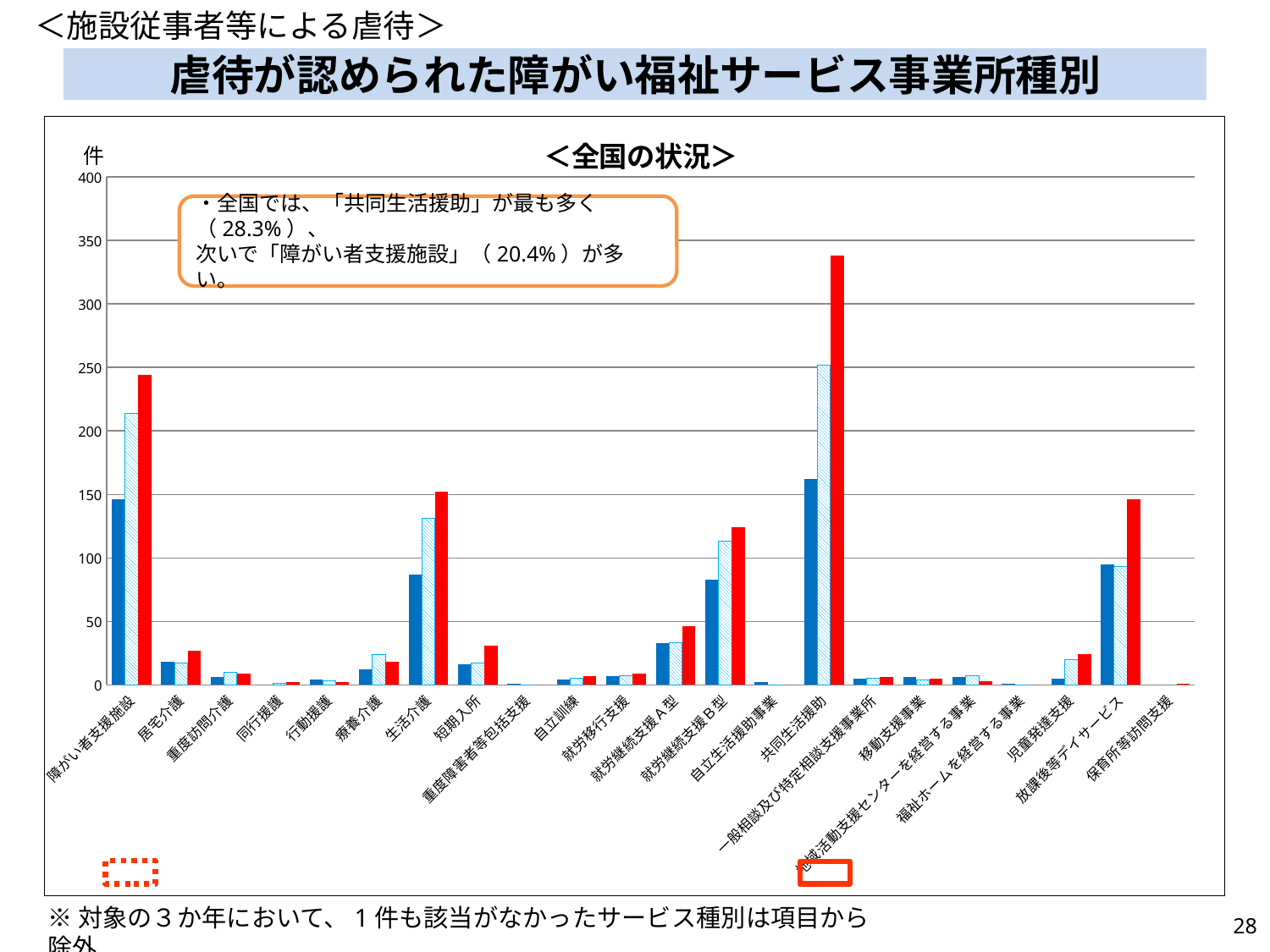
Is the red bar for 居宅介護 greater or less than 50? less Which has the larger red bar, 就労継続支援Ａ型 or 就労継続支援Ｂ型? 就労継続支援Ｂ型 How many service-type categories are shown on the x axis? 22 Is the dark blue bar for 共同生活援助 greater or less than 150? greater Which has the larger red bar, 障がい者支援施設 or 生活介護? 障がい者支援施設 What is the title shown above the chart's plot area? ＜全国の状況＞ Is the red bar for 生活介護 greater or less than 100? greater What unit label is shown at the top of the vertical axis? 件 Which category has the tallest red bar? 共同生活援助 What kind of chart is shown on the slide? bar chart